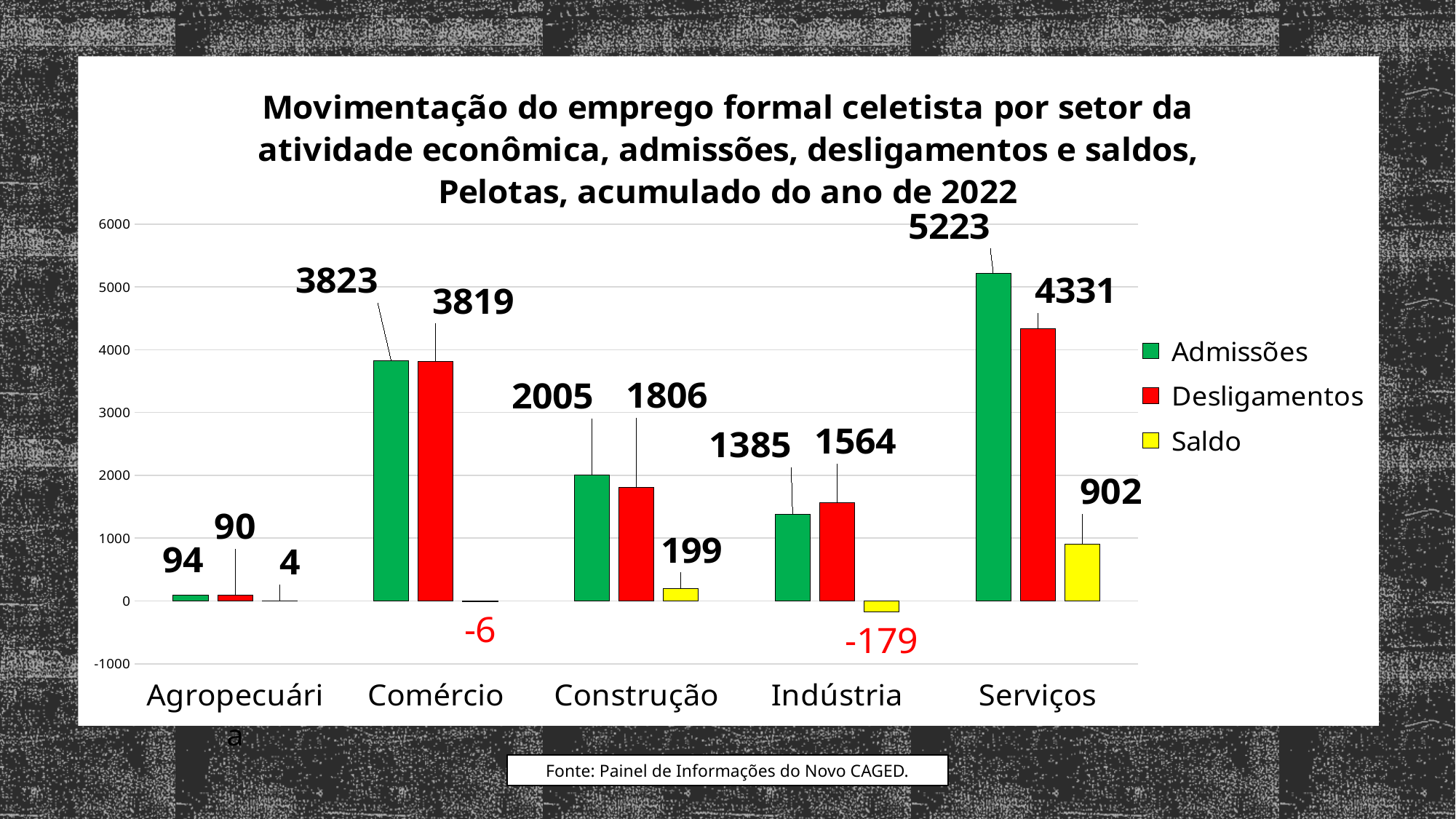
What is the difference between Admissões and Desligamentos for Serviços? 892 How many sectors are shown on the x axis? 5 What kind of chart is shown on the slide? Bar chart What is the value of Admissões for Serviços? 5223 What is the value of Desligamentos for Comércio? 3819 Which is larger for Indústria, Admissões or Desligamentos? Desligamentos What is the Saldo value for Construção? 199 What colour represents the Saldo series in the legend? Yellow What is the Saldo value for Indústria? -179 Which sector has the lowest Desligamentos value? Agropecuária Which sector has the highest Admissões value? Serviços How many series does the legend list? 3